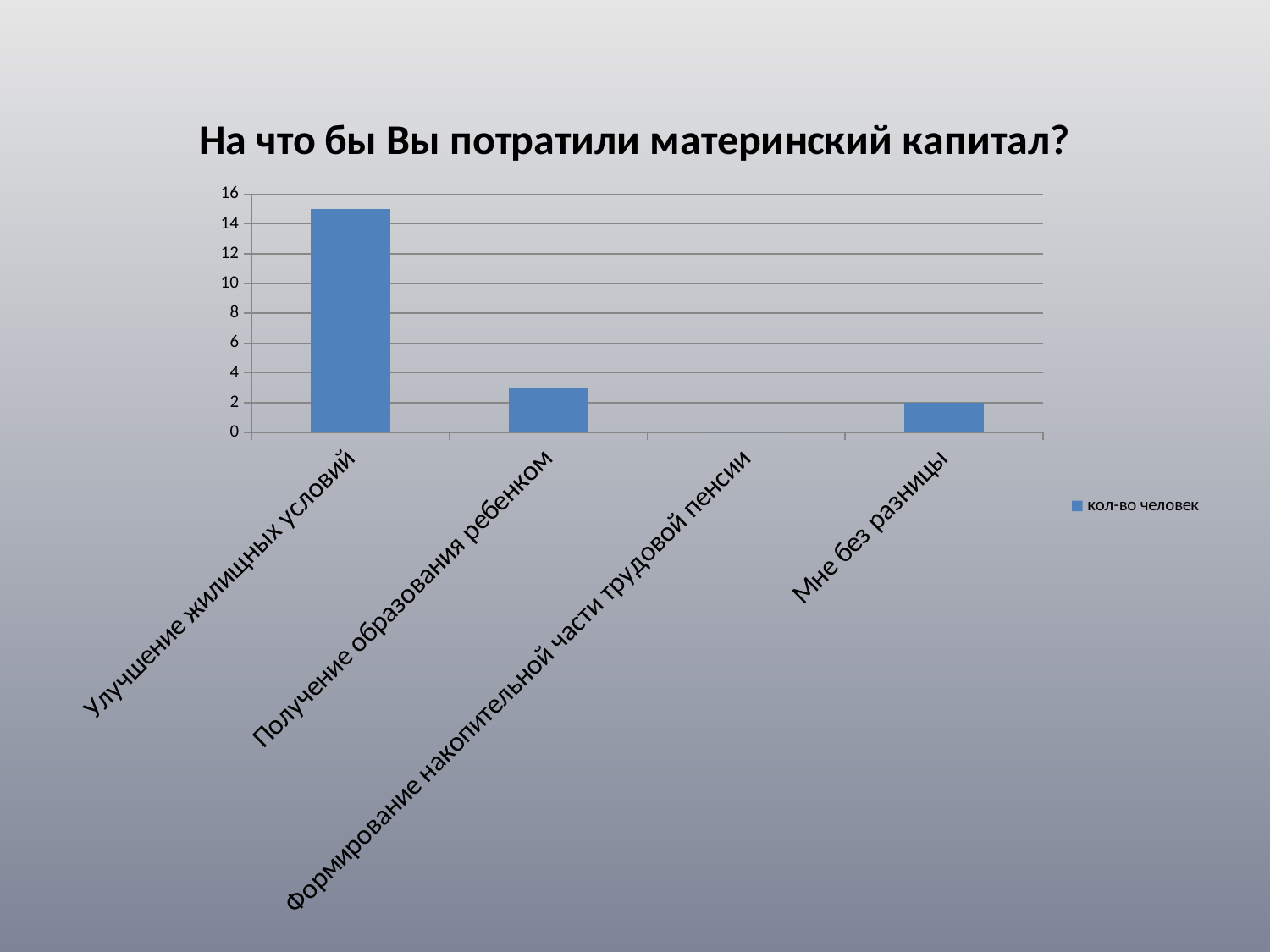
How many categories are shown on the x axis of the chart? 4 Is the value for Улучшение жилищных условий greater or less than 10? greater What is the name of the series shown in the legend? кол-во человек What is the value for Формирование накопительной части трудовой пенсии? 0 How many series does the legend list? 1 What type of chart is shown on the slide? Bar chart Is the value for Мне без разницы greater or less than 4? less What is the title of the chart? На что бы Вы потратили материнский капитал? Is the value for Получение образования ребенком greater or less than 4? less Which is larger: the value for Получение образования ребенком or the value for Мне без разницы? Получение образования ребенком Which category has the highest value? Улучшение жилищных условий Which category has the lowest value? Формирование накопительной части трудовой пенсии